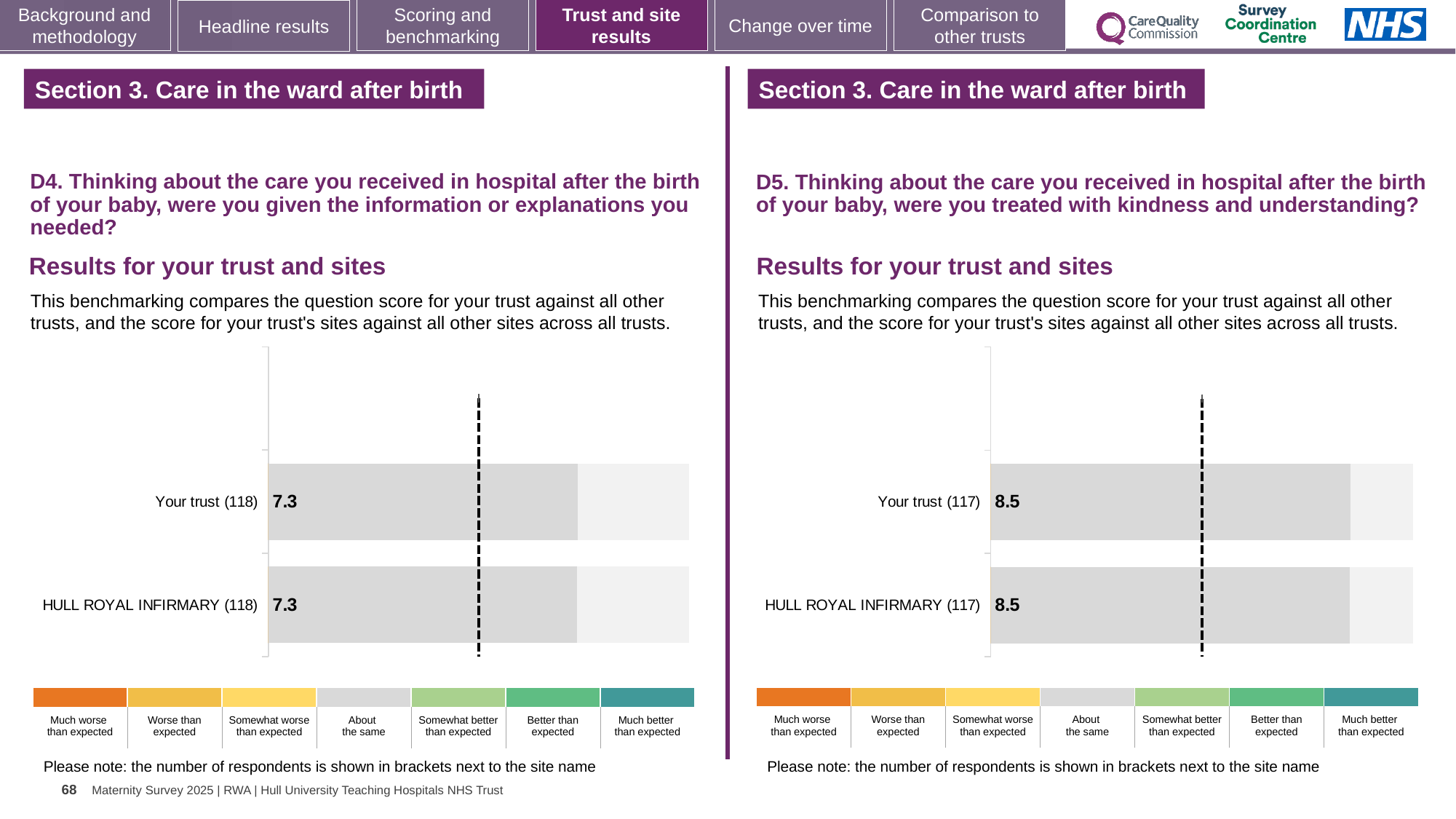
In the D4 chart on the left, how many respondents are shown in brackets next to Your trust? 118 In the D5 chart on the right, how many respondents are shown in brackets next to HULL ROYAL INFIRMARY? 117 In the D4 chart on the left, what is the score for HULL ROYAL INFIRMARY? 7.3 In the D4 chart on the left, what is the difference between the score for Your trust and the score for HULL ROYAL INFIRMARY? 0.0 In the D5 chart on the right, what is the score for Your trust? 8.5 What kind of chart is the D4 chart on the left? Bar chart In the D4 chart on the left, what is the score for Your trust? 7.3 How many bars are plotted in the D5 chart on the right? 2 In the D5 chart on the right, what is the difference between the score for Your trust and the score for HULL ROYAL INFIRMARY? 0.0 How many categories does the colour key below the D5 chart on the right list? 7 How many bars are plotted in the D4 chart on the left? 2 In the D5 chart on the right, what is the score for HULL ROYAL INFIRMARY? 8.5